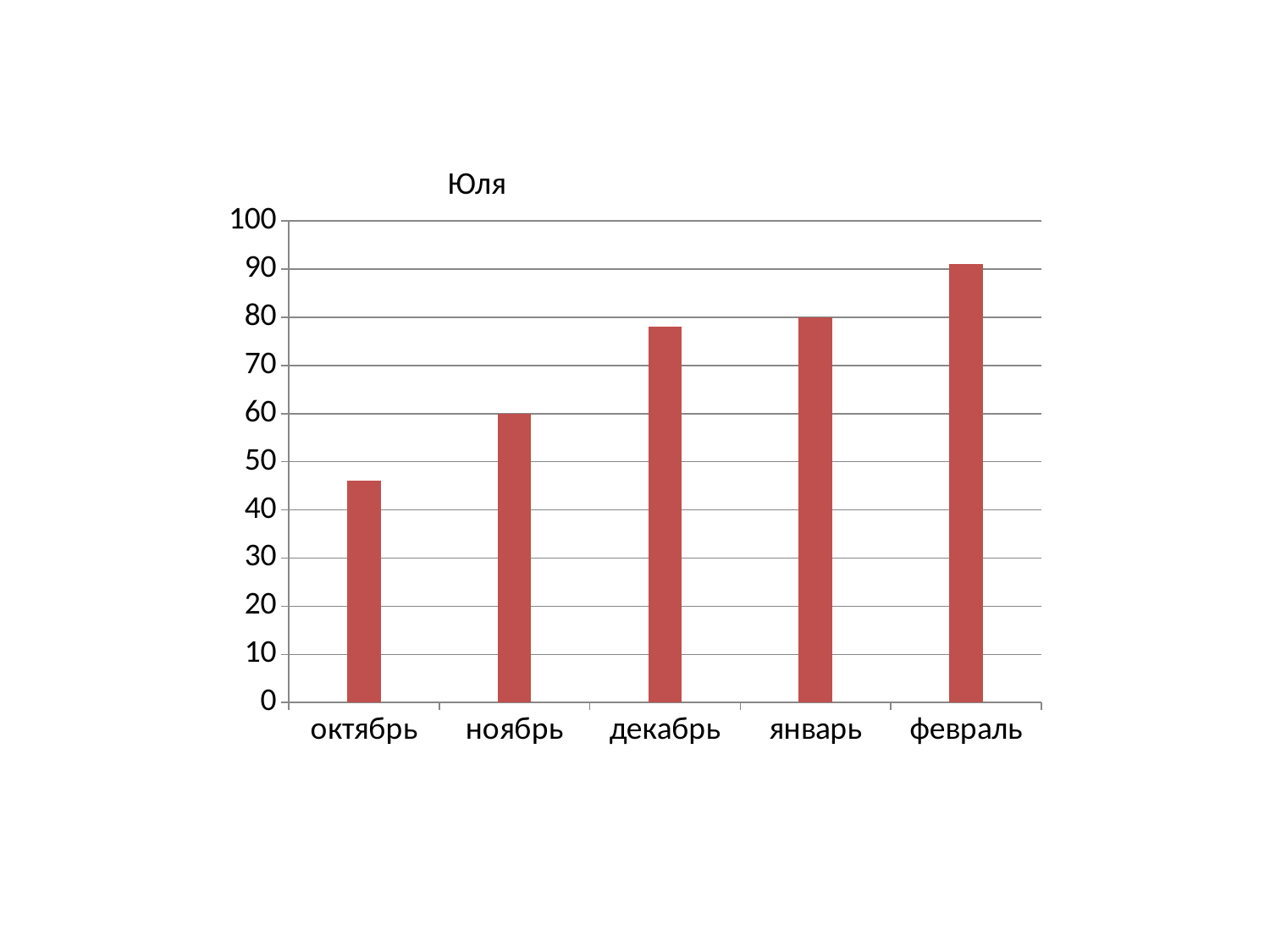
Do the values rise or fall from октябрь to февраль? rise Which is larger, the value for декабрь or the value for ноябрь? декабрь What is the value for январь? 80 What is the title of the chart? Юля What is the difference between the values for январь and ноябрь? 20 Which month has the lowest value? октябрь What kind of chart is shown on the slide? bar chart Which month has the highest value? февраль What is the value for ноябрь? 60 Is the value for октябрь greater or less than 50? less How many categories are shown on the x axis? 5